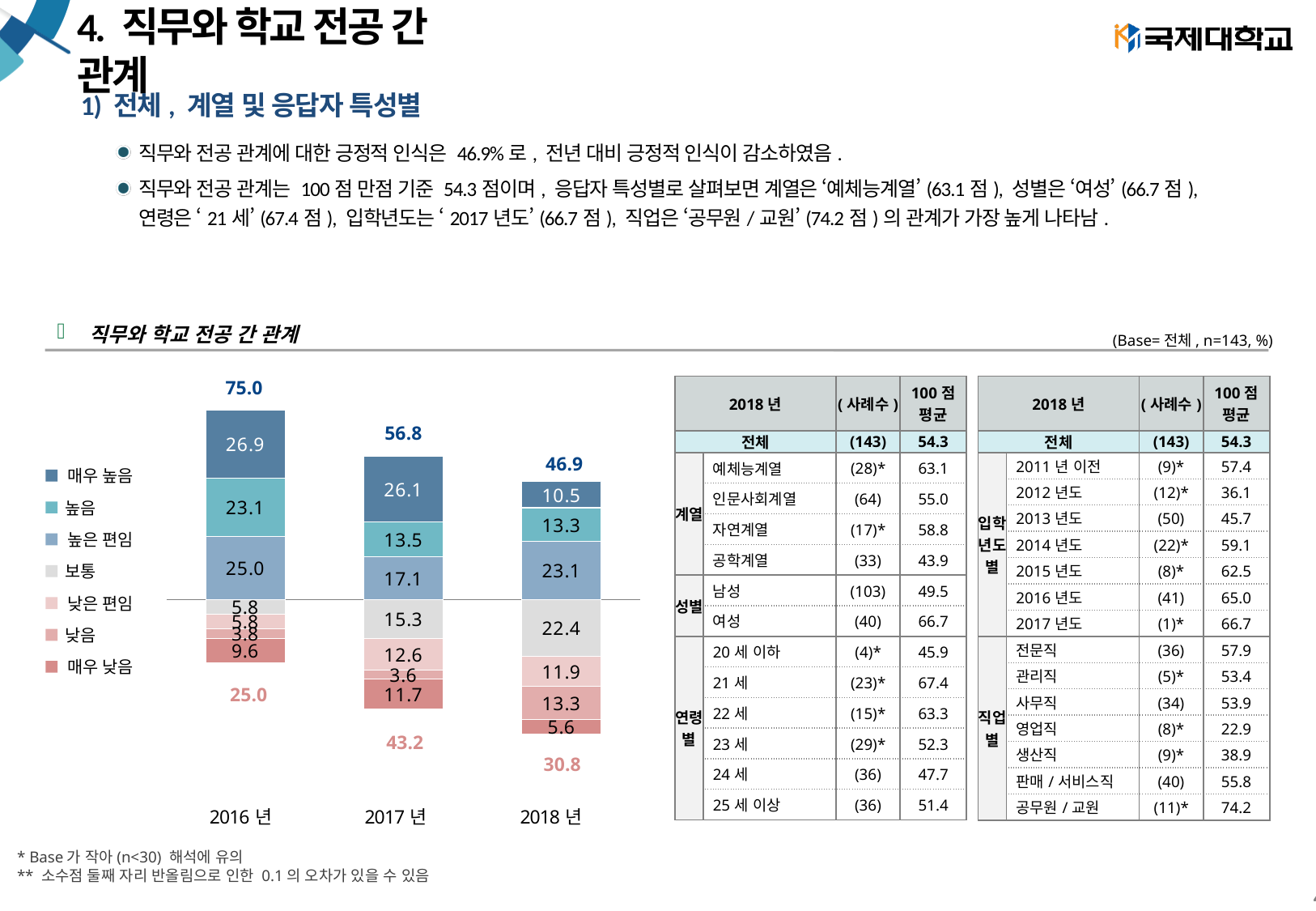
What is the negative total shown below the 2017년 bar? 43.2 What is the value for '매우 높음' in 2018년? 10.5 Which year has the highest positive total? 2016년 How many series does the chart legend list? 7 What kind of chart is shown on the slide? stacked bar chart What is the difference between the positive totals of 2016년 and 2018년? 28.1 How many years (categories) are plotted on the x axis of the chart? 3 What is the positive total (sum of 매우 높음, 높음, 높은 편임) shown above the 2016년 bar? 75.0 Does the positive total rise or fall from 2016년 to 2018년? fall What is the value for '매우 낮음' in 2016년? 9.6 What is the value for '보통' in 2017년? 15.3 Which year has the lowest positive total? 2018년